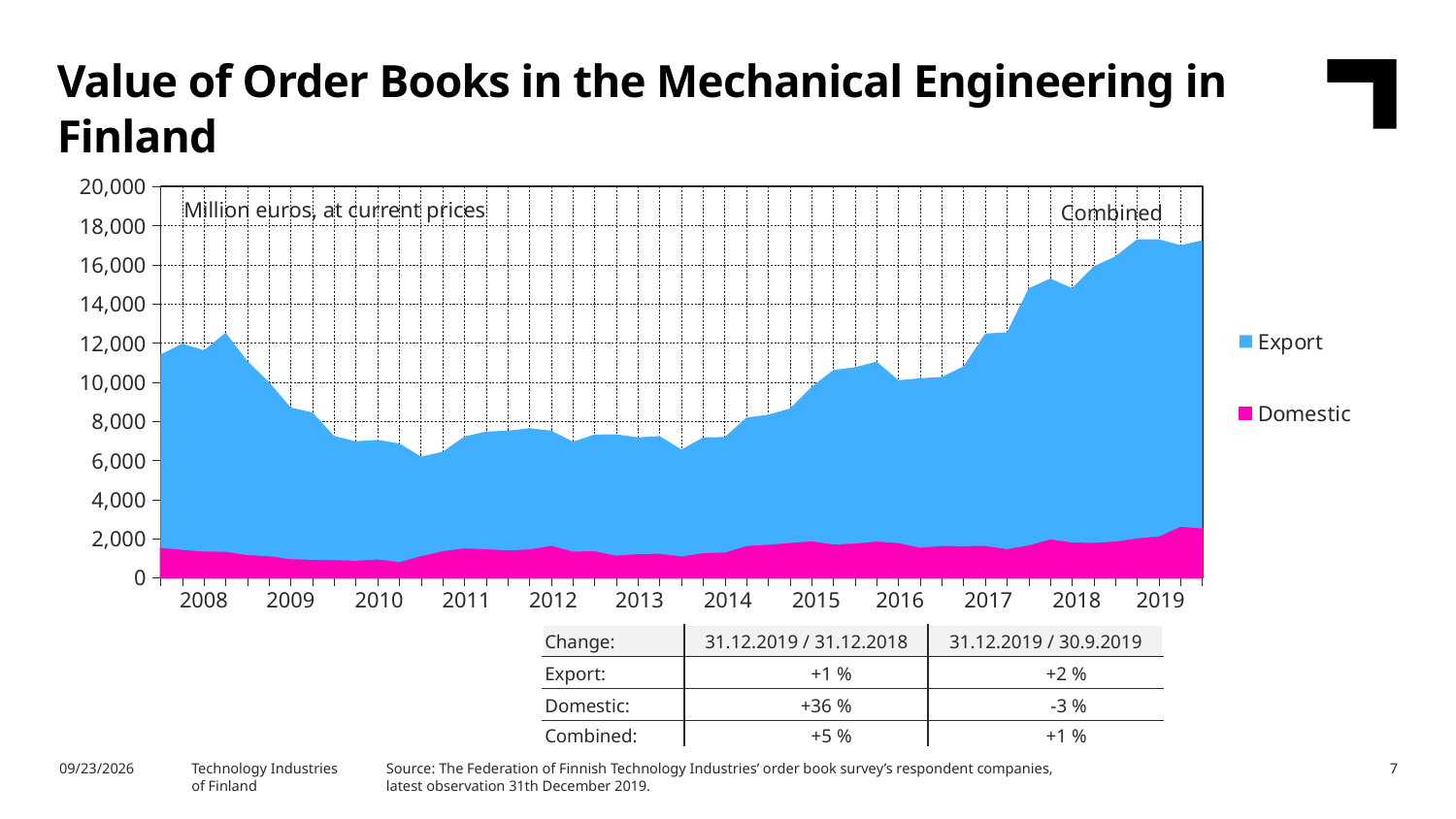
How many years are labelled on the x axis of the chart? 12 Is the combined value of order books at the end of 2019 greater or less than 16,000? greater Is the combined value of order books during 2013 greater or less than 8,000? less Which series, Export or Domestic, has the larger value at the end of 2019? Export Is the combined value of order books at the start of 2008 greater or less than 10,000? greater How many series does the legend list? 2 Which two series are listed in the chart legend? Export and Domestic Does the combined value of order books rise or fall between 2016 and 2019? rise Does the combined value of order books rise or fall between 2008 and 2010? fall What unit is stated in the chart for the values plotted? Million euros, at current prices What kind of chart is shown on the slide? Stacked area chart